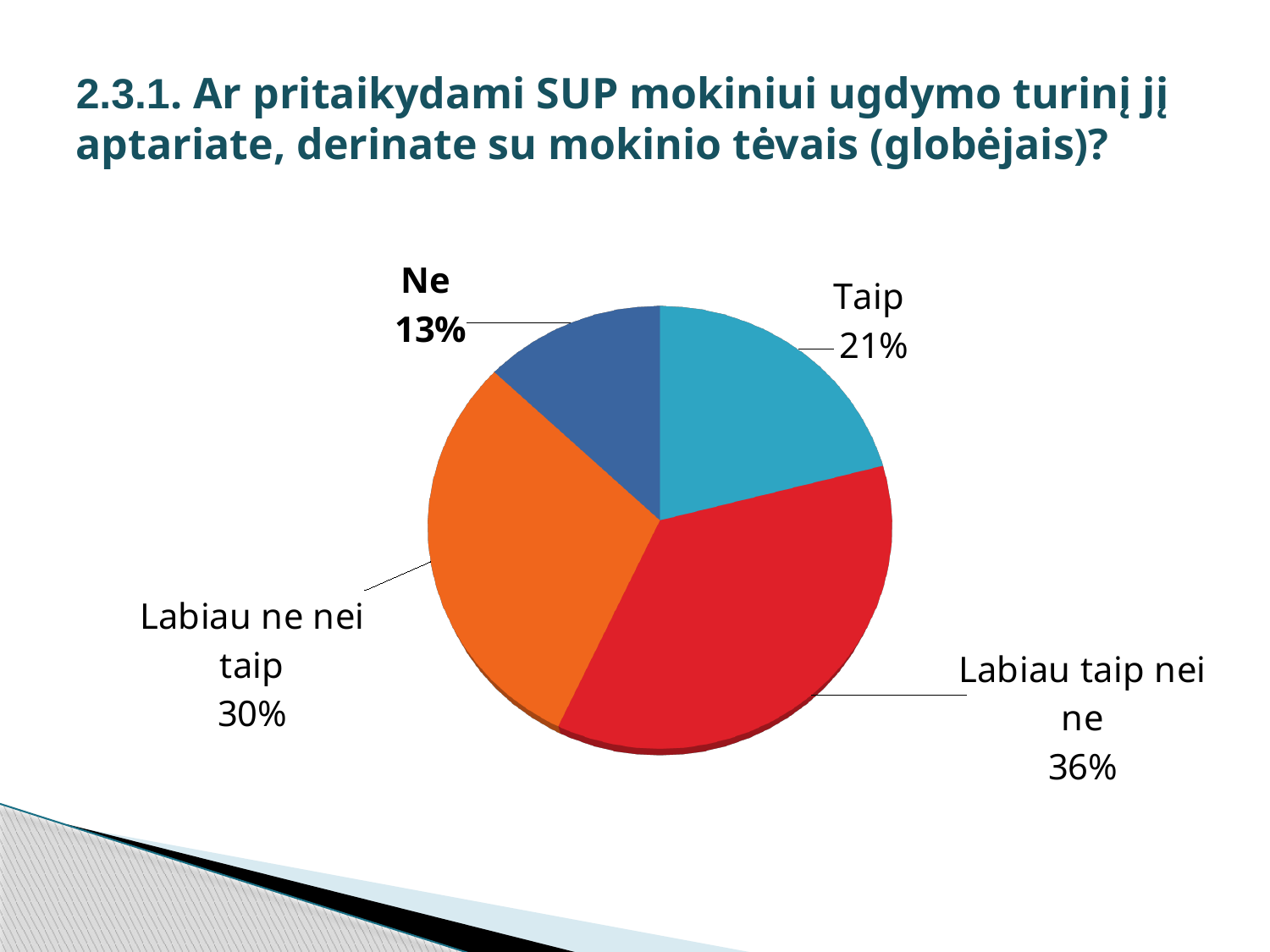
What colour is the slice for "Taip"? light blue What share of the pie does "Ne" have? 13% Which is larger, the share for "Labiau ne nei taip" or the share for "Ne"? Labiau ne nei taip Which category has the smallest slice of the pie? Ne What share of the pie does "Labiau ne nei taip" have? 30% Which category has the largest slice of the pie? Labiau taip nei ne What is the difference in percentage points between "Labiau ne nei taip" and "Ne"? 17% What share of the pie does "Labiau taip nei ne" have? 36% How many slices does the pie chart have? 4 What kind of chart is shown on the slide? pie chart What is the difference in percentage points between "Labiau taip nei ne" and "Taip"? 15%